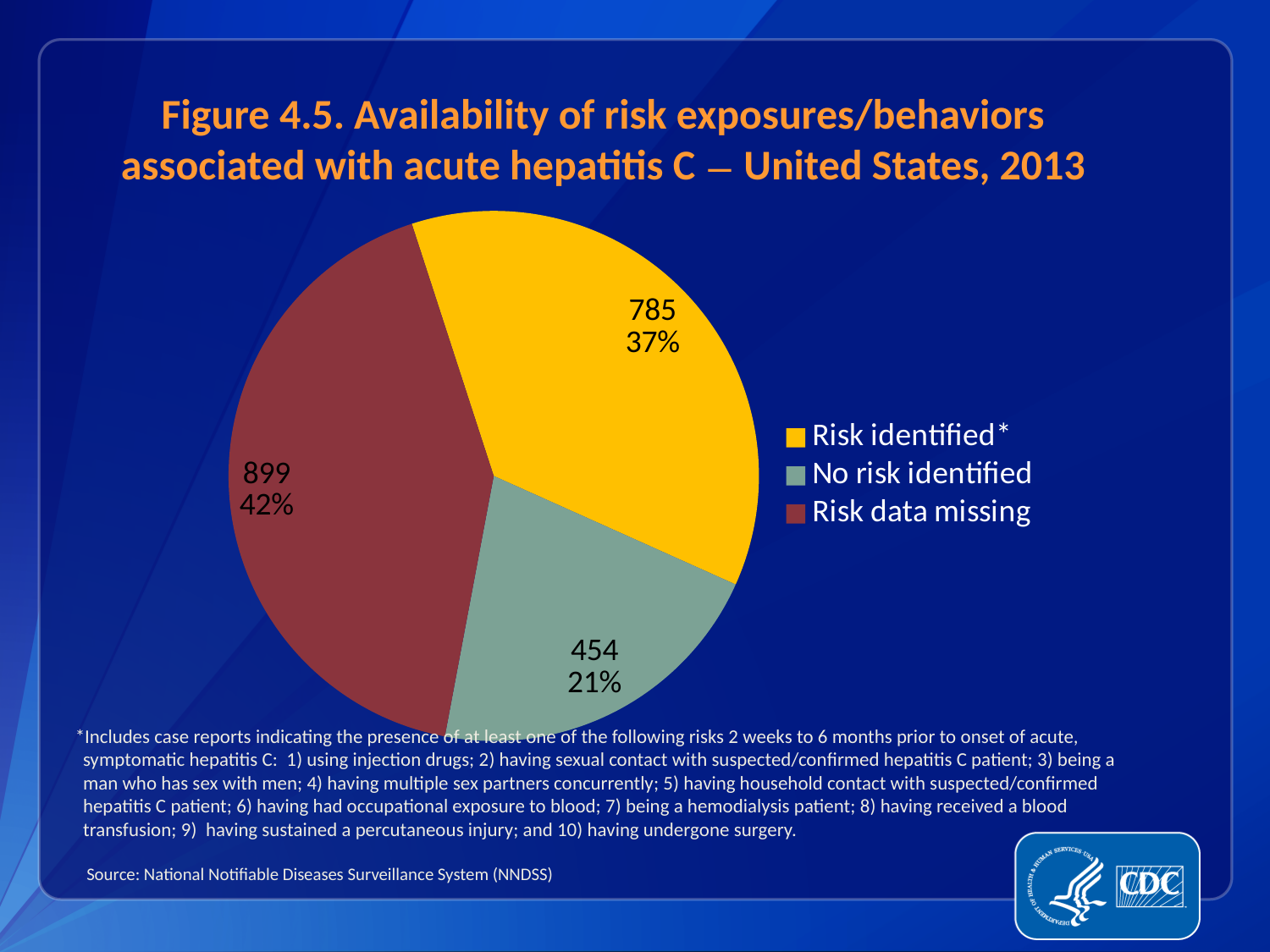
What colour is the 'No risk identified' slice? grey-green What percentage of cases had no risk identified? 21% What share of the pie does 'Risk data missing' represent? 42% What is the difference in number of cases between 'Risk data missing' and 'Risk identified*'? 114 How many categories does the pie chart show? 3 Which category has the largest slice of the pie? Risk data missing Which is larger: the number of cases with risk identified or the number with no risk identified? Risk identified* What is the total number of cases across all three slices? 2,138 How many cases are in the 'Risk data missing' slice? 899 What type of chart is shown on the slide? pie chart Which category has the smallest slice of the pie? No risk identified How many cases are in the 'Risk identified*' slice? 785